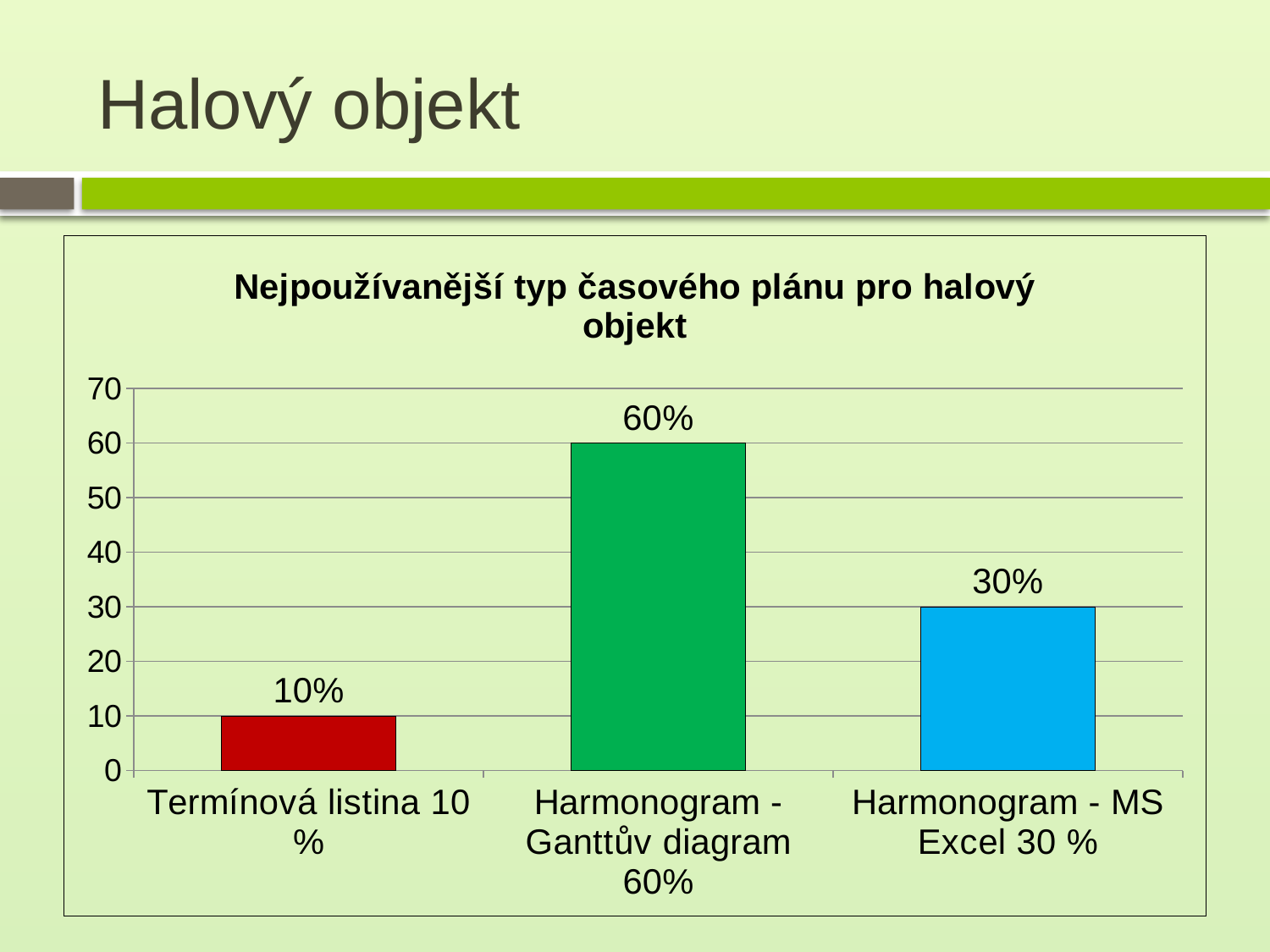
Is the value for Harmonogram - Ganttův diagram greater or less than 50? greater What kind of chart is shown on the slide? bar chart What is the value for Termínová listina? 10% What is the value for Harmonogram - MS Excel? 30% Which category has the highest value? Harmonogram - Ganttův diagram What is the difference between the values for Harmonogram - MS Excel and Termínová listina? 20% How many categories are shown in the chart? 3 Which category has the lowest value? Termínová listina Which is larger, the value for Harmonogram - MS Excel or the value for Termínová listina? Harmonogram - MS Excel What is the value for Harmonogram - Ganttův diagram? 60% What is the title of the chart? Nejpoužívanější typ časového plánu pro halový objekt What is the difference between the values for Harmonogram - Ganttův diagram and Harmonogram - MS Excel? 30%